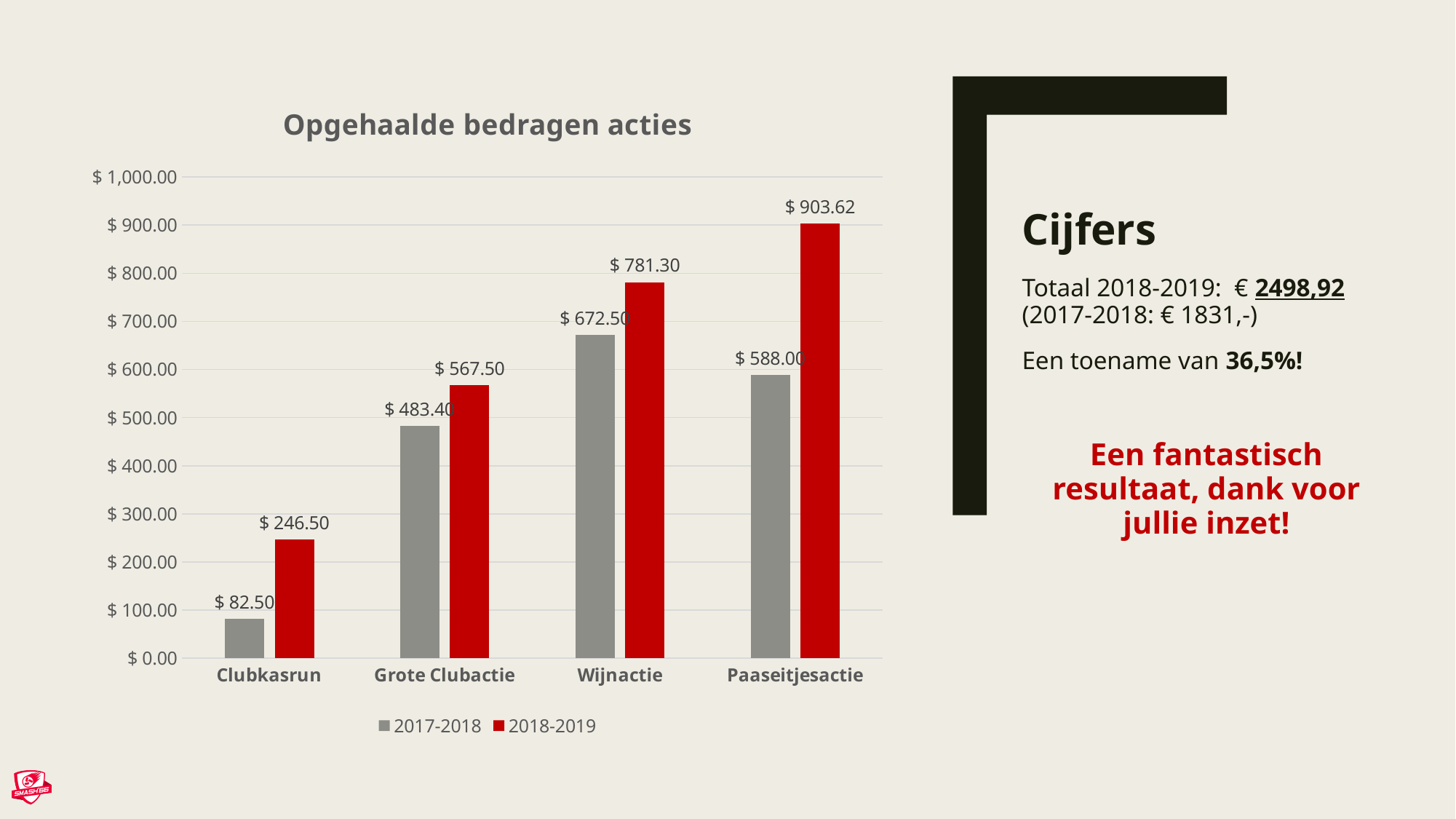
Is the 2018-2019 value for Grote Clubactie greater or less than $ 500.00? greater How many categories are shown on the x axis? 4 Which category has the highest value in the 2017-2018 series? Wijnactie What is the title of the chart? Opgehaalde bedragen acties How many series does the legend list? 2 What is the value for Wijnactie in the 2018-2019 series? $ 781.30 What is the difference between the 2018-2019 and 2017-2018 values for Paaseitjesactie? $ 315.62 Which is larger: the 2017-2018 value for Wijnactie or the 2018-2019 value for Grote Clubactie? 2017-2018 value for Wijnactie What is the value for Clubkasrun in the 2017-2018 series? $ 82.50 Which category has the lowest value in the 2018-2019 series? Clubkasrun What is the value for Paaseitjesactie in the 2018-2019 series? $ 903.62 What kind of chart is shown on the slide? Bar chart